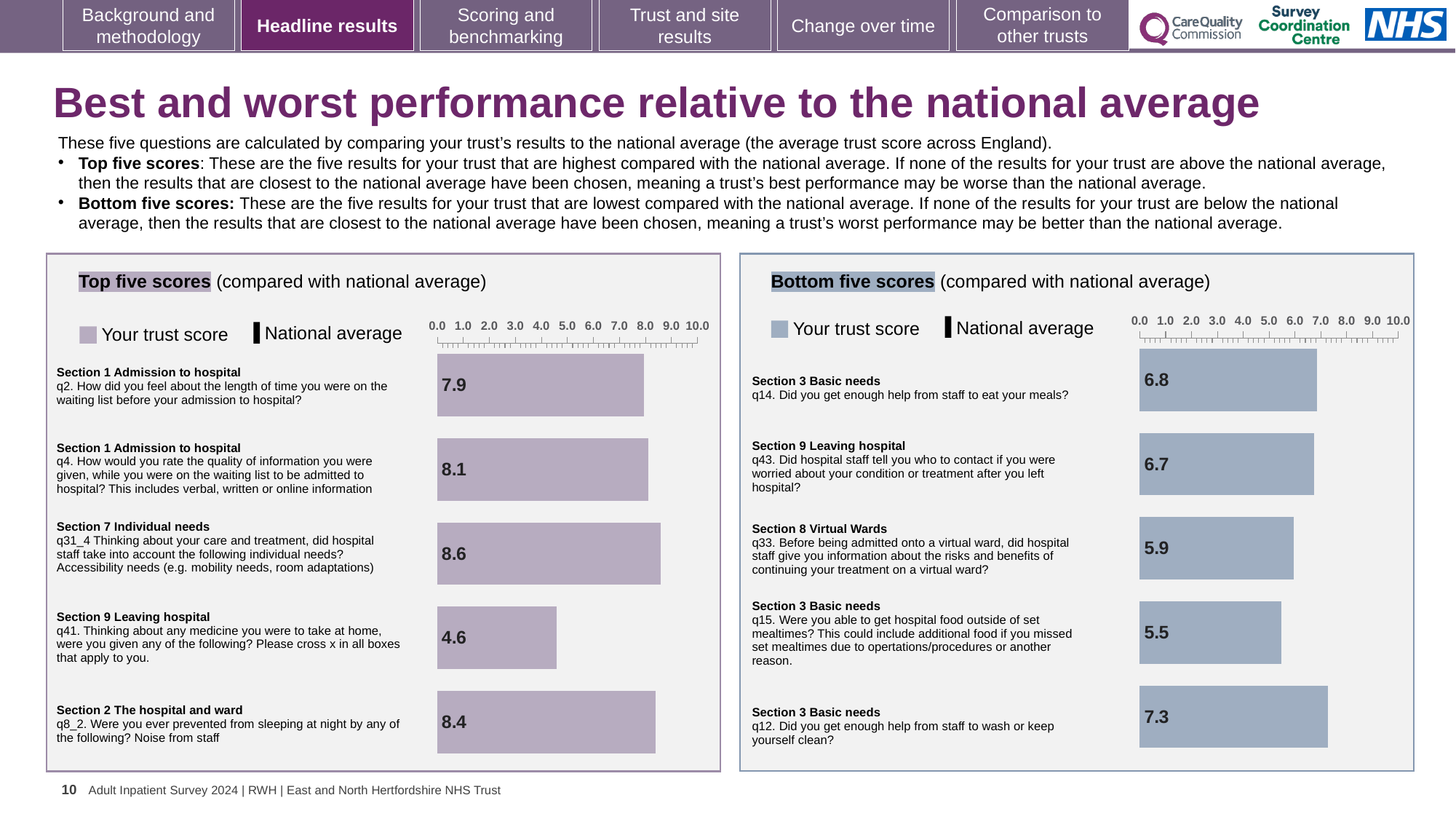
In the Bottom five scores chart, which is larger: the trust score for q43 or for q33? q43 In the Bottom five scores chart, what is the trust score for q12 about help from staff to wash or keep yourself clean? 7.3 What type of chart is the Top five scores chart? Bar chart In the Bottom five scores chart, what is the trust score for q14 about getting enough help from staff to eat meals? 6.8 In the Bottom five scores chart, which question has the highest trust score? q12 (help to wash or keep yourself clean) In the Top five scores chart, what is the trust score for q2 about the length of time on the waiting list before admission? 7.9 In the Top five scores chart, what is the trust score for q31_4 about accessibility needs being taken into account? 8.6 In the Top five scores chart, what is the difference between the trust scores for q4 and q41? 3.5 In the Top five scores chart, which question has the highest trust score? q31_4 (accessibility needs) How many questions are plotted in the Bottom five scores chart? 5 In the Top five scores chart, which question has the lowest trust score? q41 (medicine to take at home) In the Bottom five scores chart, which question has the lowest trust score? q15 (hospital food outside of set mealtimes)